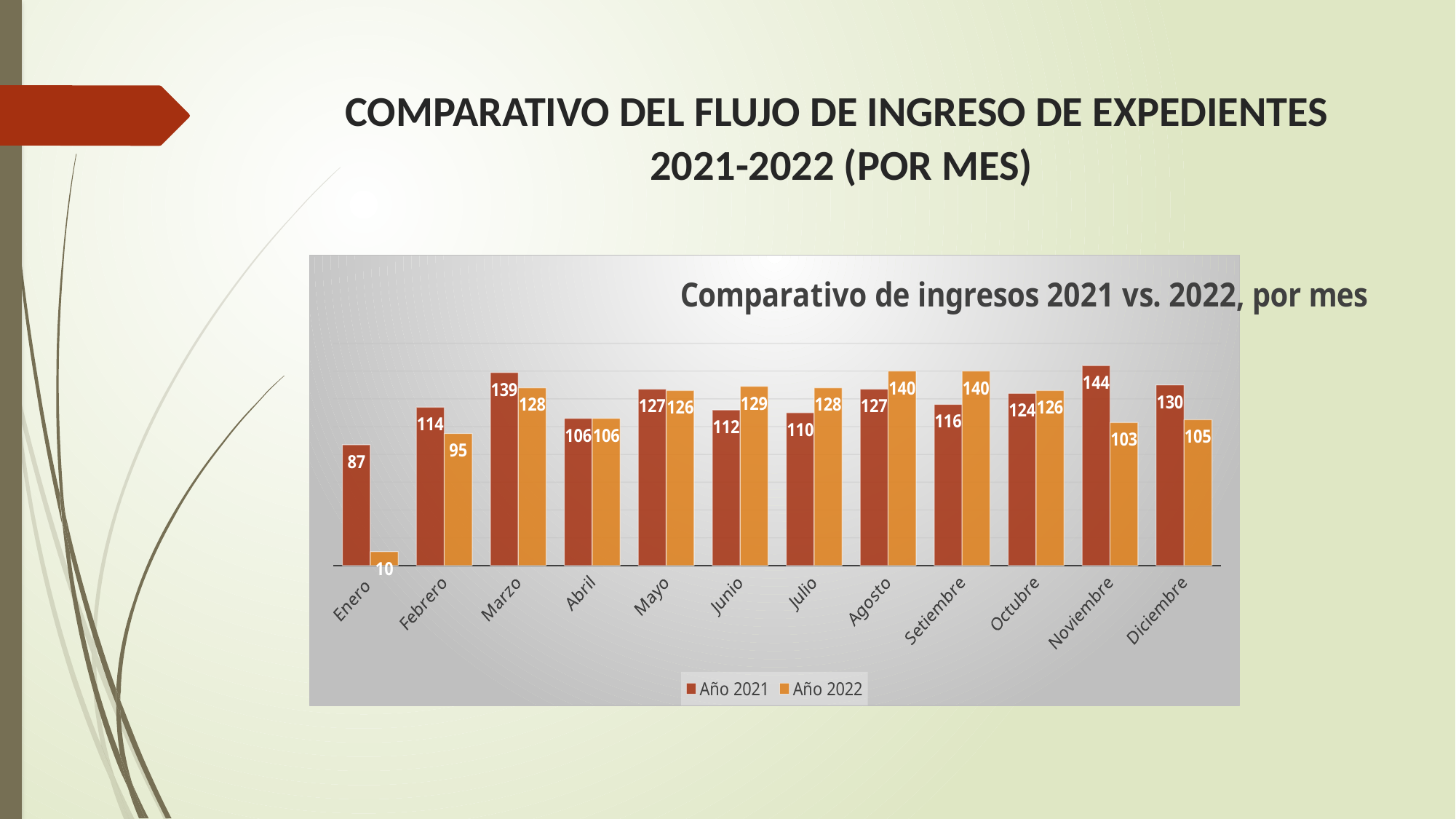
What is the value for Año 2021 in Marzo? 139 How many months are shown on the x axis? 12 What is the title of the chart? Comparativo de ingresos 2021 vs. 2022, por mes What is the difference between Año 2021 and Año 2022 in Diciembre? 25 Which month has the lowest value for Año 2022? Enero What is the difference between Año 2021 and Año 2022 in Febrero? 19 What is the value for Año 2022 in Noviembre? 103 What is the value for Año 2022 in Enero? 10 What kind of chart is shown on the slide? Bar chart How many series does the legend list? 2 Which month has the highest value for Año 2021? Noviembre Which is larger in Setiembre, Año 2021 or Año 2022? Año 2022